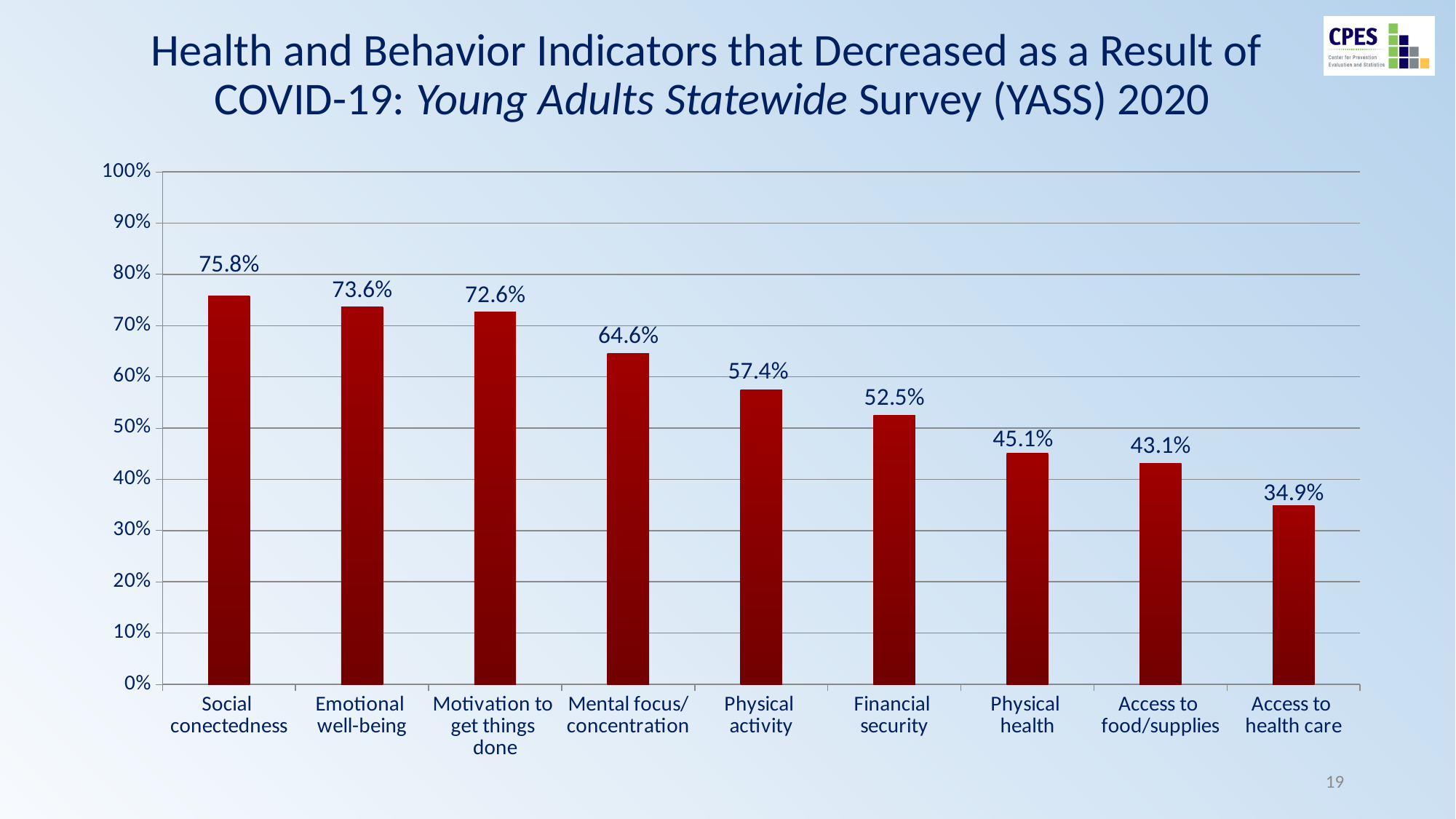
What is the value for Financial security? 52.5% Which category has the lowest value? Access to health care What kind of chart is shown on the slide? bar chart What colour are the bars in the chart? dark red Which category has the highest value? Social conectedness How many categories are shown on the x axis? 9 What is the value for Social conectedness? 75.8% What is the value for Access to food/supplies? 43.1% Which is larger, the value for Mental focus/concentration or the value for Financial security? Mental focus/concentration What is the difference between the values for Physical activity and Physical health? 12.3% Is the value for Access to health care greater or less than 40%? less Do the values rise or fall from left to right along the x axis? fall